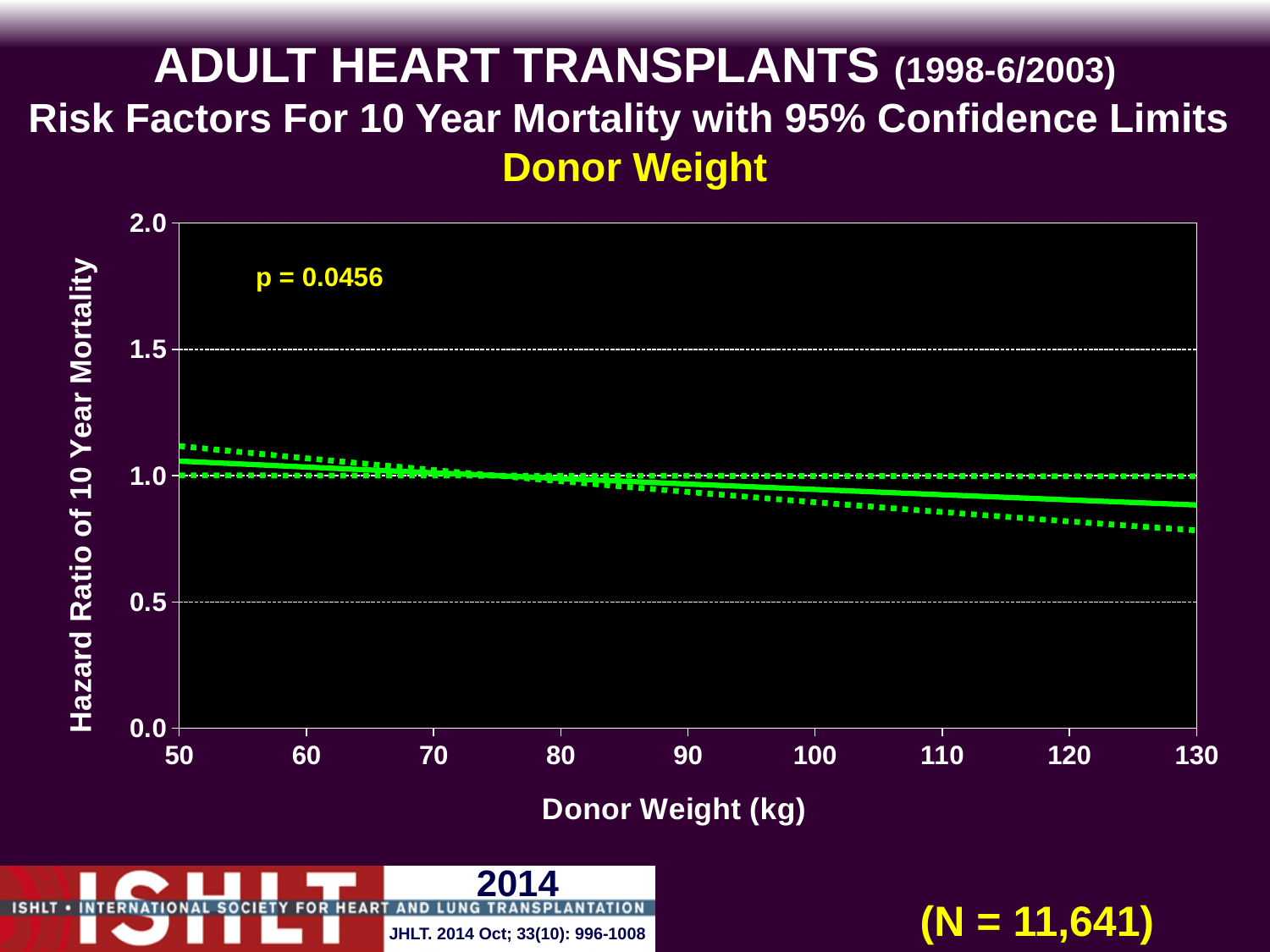
What is the lowest donor weight shown on the x axis? 50 Is the hazard ratio for a donor weight of 120 kg greater or less than 1.5? less Does the hazard ratio (solid line) rise or fall as donor weight increases from 50 to 130 kg? fall What p-value is printed on the chart? p = 0.0456 What kind of chart is shown on the slide? line chart Is the hazard ratio for a donor weight of 130 kg greater or less than 1.0? less What is the highest value shown on the y axis? 2.0 What is the label of the x axis? Donor Weight (kg) Which donor weight has the higher hazard ratio, 50 kg or 130 kg? 50 kg Is the hazard ratio for a donor weight of 50 kg greater or less than 1.0? greater